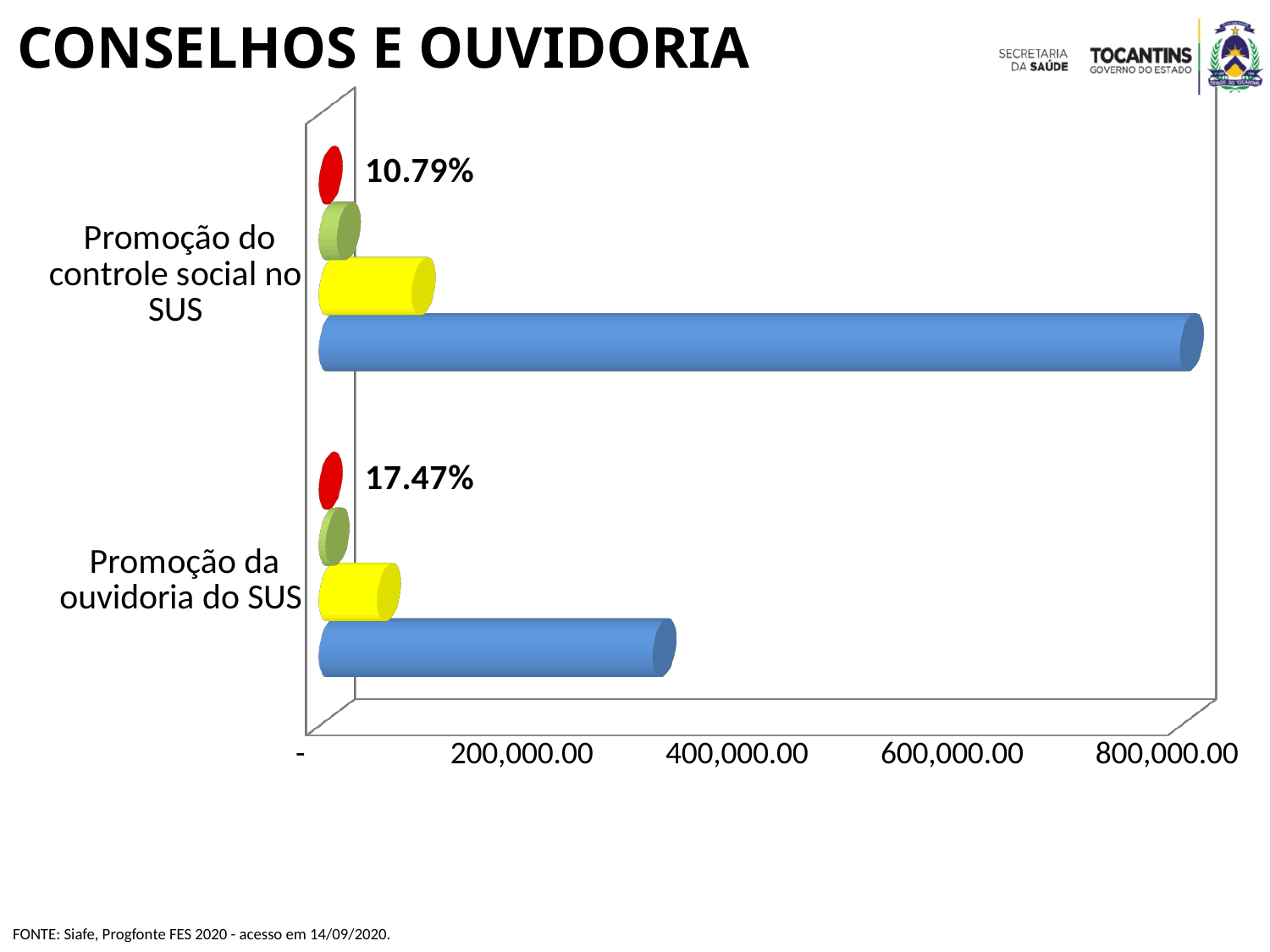
What is the highest value shown on the horizontal axis of the chart? 800,000.00 Which category has the longest blue bar? Promoção do controle social no SUS What kind of chart is shown on the slide? bar chart What percentage is labelled for Promoção do controle social no SUS? 10.79% Is the value of the blue bar for Promoção da ouvidoria do SUS greater or less than 400,000.00? less How many categories are shown on the chart? 2 Is the value of the blue bar for Promoção da ouvidoria do SUS greater or less than 200,000.00? greater What is the difference between the percentage labels for Promoção da ouvidoria do SUS and Promoção do controle social no SUS? 6.68% Is the value of the blue bar for Promoção do controle social no SUS greater or less than 600,000.00? greater What percentage is labelled for Promoção da ouvidoria do SUS? 17.47% Which category has the larger percentage label, Promoção do controle social no SUS or Promoção da ouvidoria do SUS? Promoção da ouvidoria do SUS